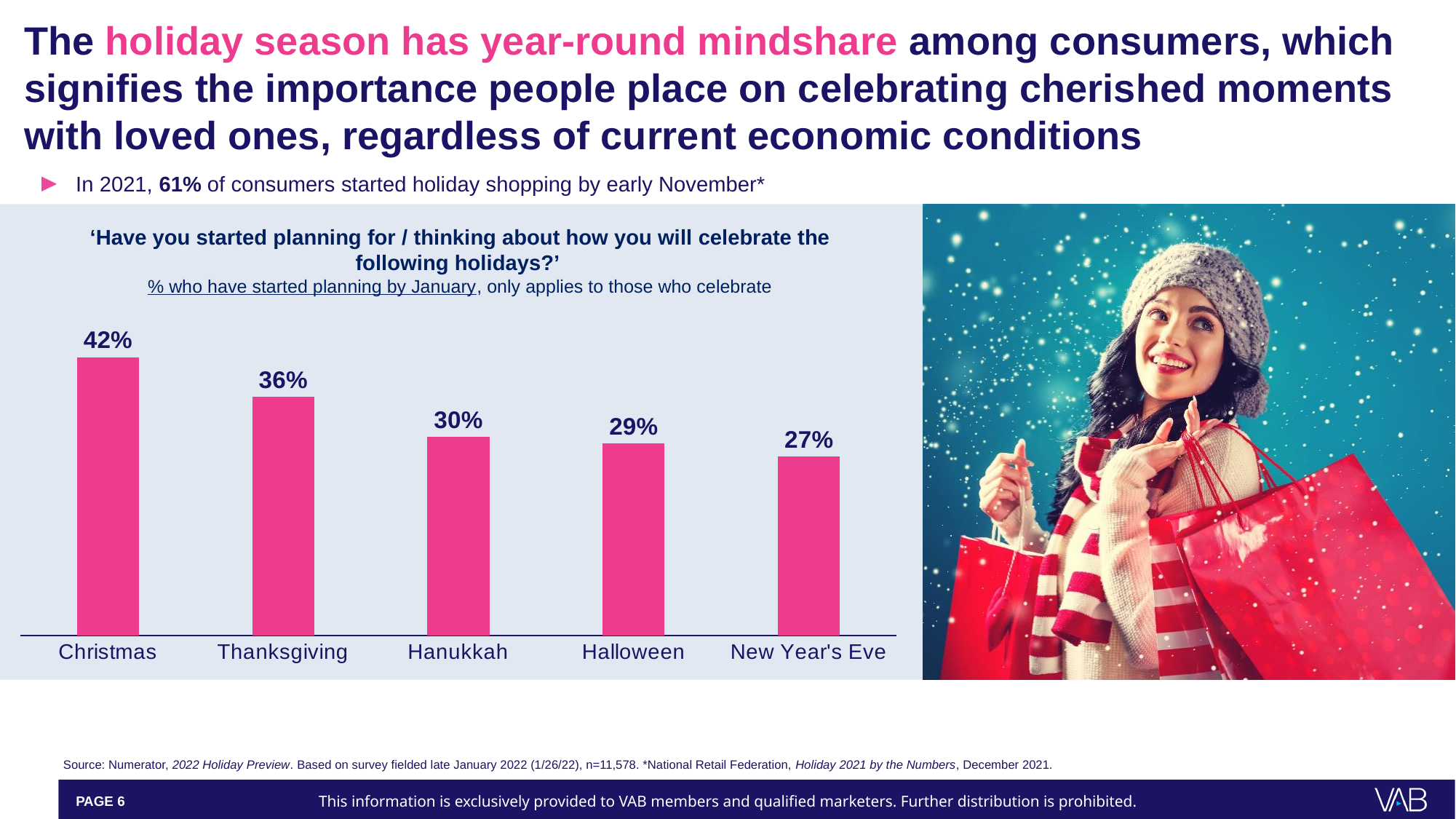
Which holiday has the lowest value in the chart? New Year's Eve How many holidays are shown in the chart? 5 What is the difference between the Hanukkah and New Year's Eve values? 3 percentage points Which holiday has the highest share of people who have started planning by January? Christmas What is the value for New Year's Eve? 27% What is the value shown for Thanksgiving? 36% What is the difference in percentage points between Christmas and Thanksgiving? 6 percentage points Which has a higher value, Thanksgiving or Halloween? Thanksgiving What type of chart is used on the slide? Bar chart What percentage is shown for Hanukkah? 30% Do the values rise or fall moving from Christmas to New Year's Eve along the x axis? Fall What percentage of consumers have started planning for Christmas by January? 42%